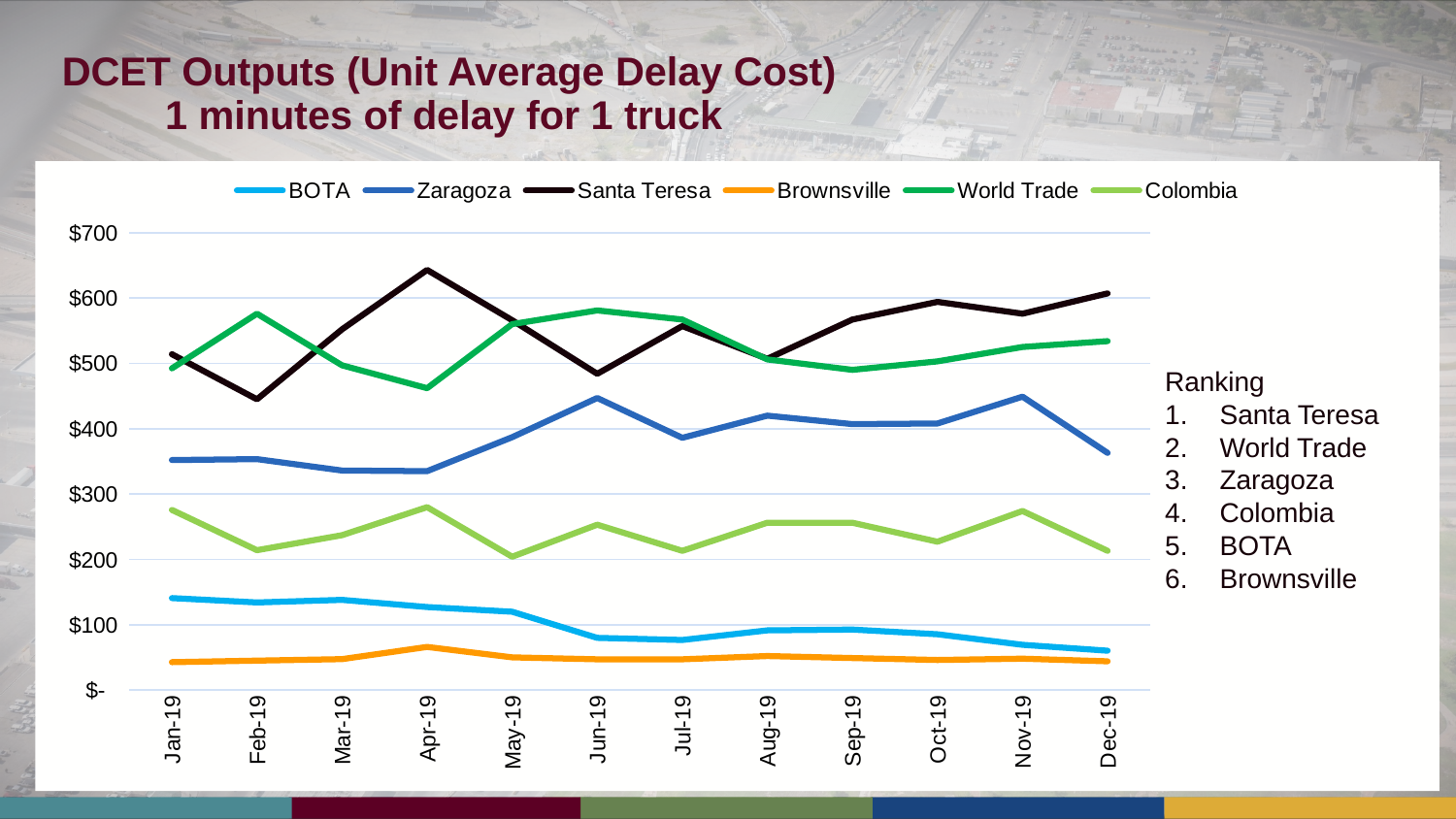
How many series does the legend list? 6 Is the value for Colombia in May-19 greater or less than $300? less In Feb-19, which is higher: World Trade or Santa Teresa? World Trade Is the value for Zaragoza in Jun-19 greater or less than $400? greater Which series has the lowest value in Jan-19? Brownsville Is the value for Santa Teresa in Apr-19 greater or less than $600? greater What kind of chart is shown on the slide? line chart Does the BOTA line rise or fall from Jan-19 to Dec-19? fall Which series has the highest value in Apr-19? Santa Teresa How many months are plotted along the x axis? 12 Which series is ranked first in the Ranking list next to the chart? Santa Teresa